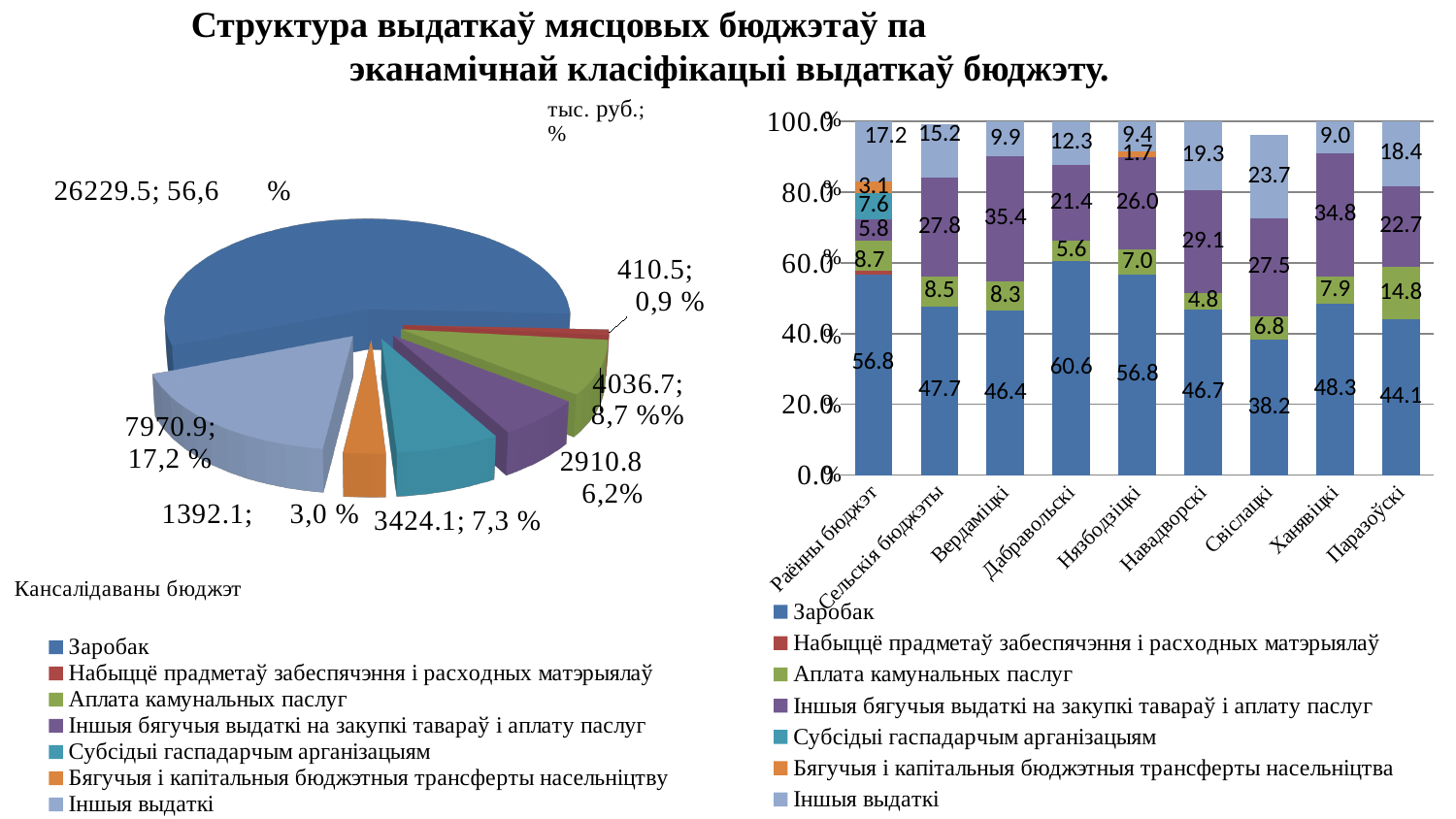
On the stacked bar chart on the right, which budget has the highest Іншыя выдаткі value? Свіслацкі (23.7) On the stacked bar chart on the right, what is the difference between the Заробак values for Дабравольскі and Свіслацкі? 22.4 How many series does the legend of the stacked bar chart on the right list? 7 On the pie chart (Кансалідаваны бюджэт), what share is shown for the slice labelled 7970.9? 17,2 % On the stacked bar chart on the right, which is larger: the Аплата камунальных паслуг value for Паразоўскі or for Навадворскі? Паразоўскі (14.8) On the pie chart (Кансалідаваны бюджэт), how many slices are there? 7 On the stacked bar chart on the right, what is the value of Заробак for Дабравольскі? 60.6 On the pie chart (Кансалідаваны бюджэт), which slice is the smallest? Набыццё прадметаў забеспячэння і расходных матэрыялаў (410.5; 0,9 %) On the stacked bar chart on the right, how many budget categories are shown on the x axis? 9 On the pie chart (Кансалідаваны бюджэт), what value and share are shown for the largest slice, Заробак? 26229.5; 56,6 % What type of chart is shown on the left side of the slide? Pie chart On the stacked bar chart on the right, which budget has the lowest Заробак value? Свіслацкі (38.2)